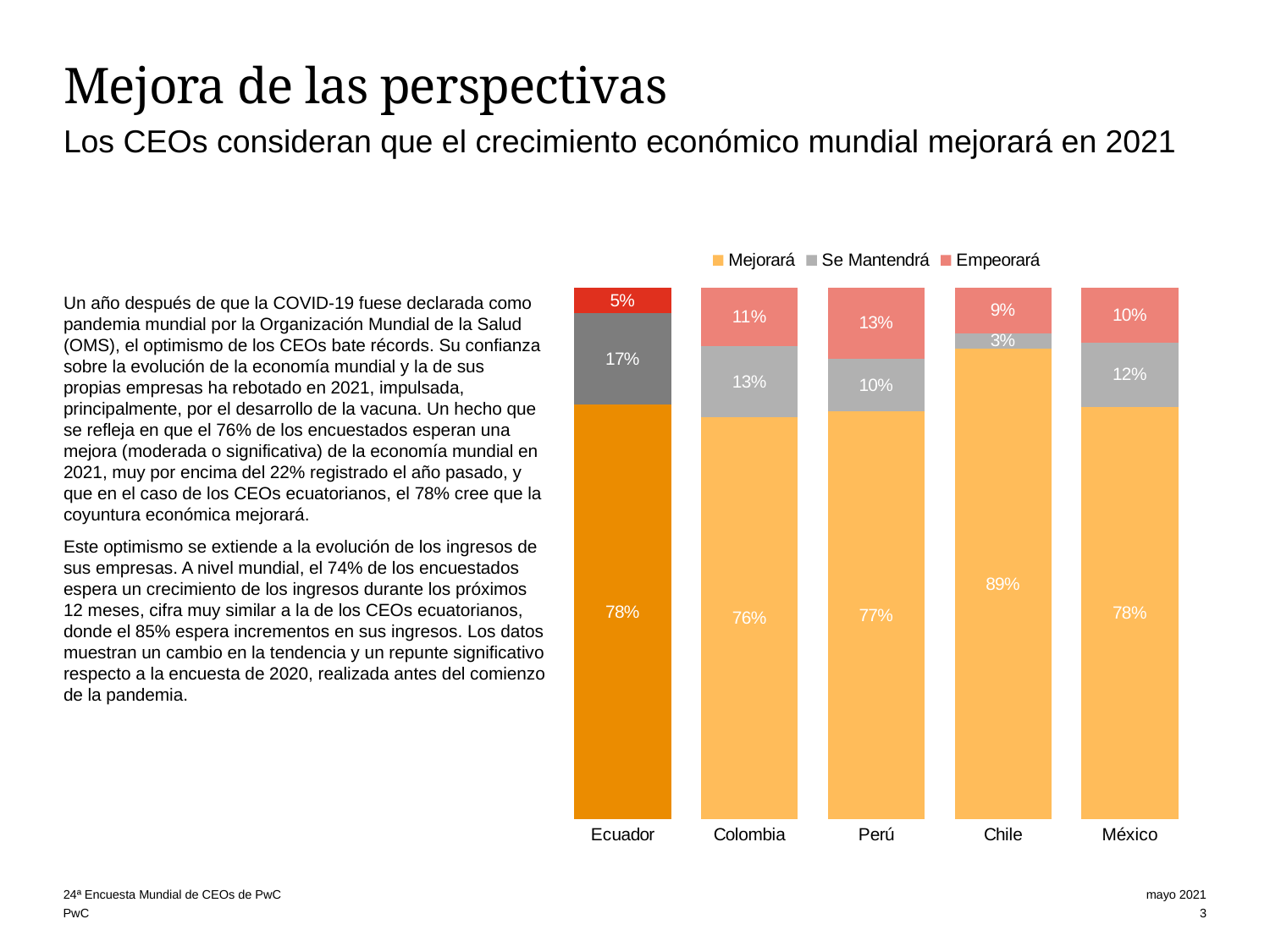
What is the "Empeorará" value for Perú? 13% What is the "Se Mantendrá" value for Ecuador? 17% What is the difference between the "Mejorará" values for Chile and Colombia? 13% What percentage of CEOs in Chile answered "Mejorará"? 89% Which is larger, the "Empeorará" value for Perú or for Ecuador? Perú How many series does the legend list? 3 What kind of chart is shown on the slide? Stacked bar chart Which series is shown in grey in the legend? Se Mantendrá Which country has the lowest "Se Mantendrá" value? Chile Which country has the highest "Mejorará" value? Chile How many countries are shown on the x axis? 5 What is the total of the stacked bar for México? 100%